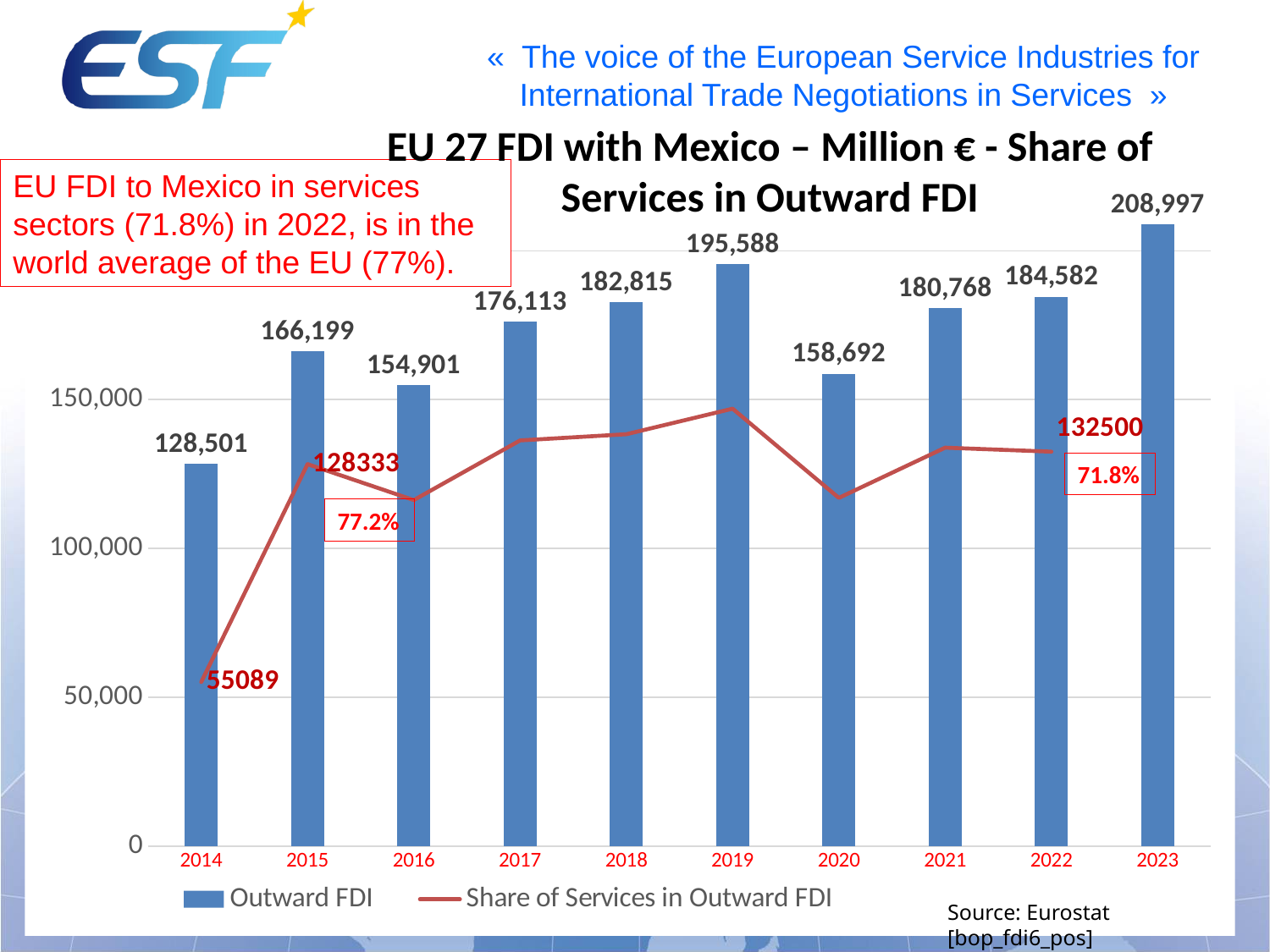
How many series does the legend list? 2 Which year has the lowest Outward FDI? 2014 What kind of chart is used to show Outward FDI? bar chart What is the Outward FDI value for 2019? 195,588 What percentage is annotated on the chart for 2022? 71.8% Which year has the larger Outward FDI, 2016 or 2020? 2020 Which year has the highest Outward FDI? 2023 How many years are shown on the x axis? 10 Is the Share of Services in Outward FDI line value for 2019 greater or less than 150,000? less What is the labelled value of the Share of Services in Outward FDI line for 2015? 128333 What is the difference between the Outward FDI values for 2023 and 2022? 24,415 What is the Outward FDI value for 2014? 128,501